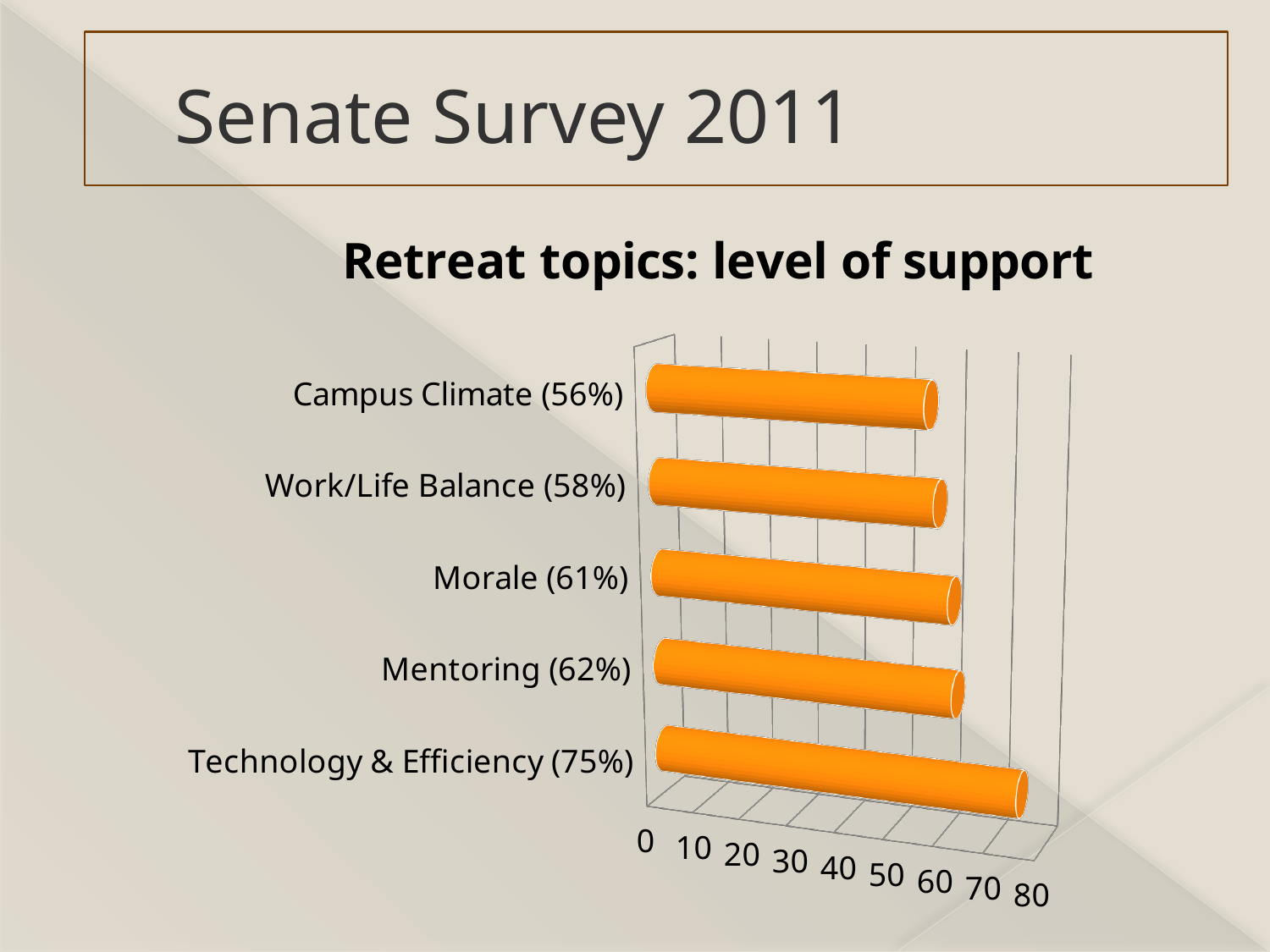
Which retreat topic has the highest level of support? Technology & Efficiency What is the chart's title? Retreat topics: level of support Which has a higher level of support, Mentoring or Work/Life Balance? Mentoring What kind of chart is shown on the slide? bar chart What level of support is shown for Technology & Efficiency? 75% Is the value for Technology & Efficiency greater or less than 70? greater What is the difference in support between Mentoring and Morale? 1% Which retreat topic has the lowest level of support? Campus Climate What is the difference in support between Technology & Efficiency and Campus Climate? 19% How many retreat topics are plotted in the chart? 5 What level of support is shown for Campus Climate? 56% What level of support is shown for Morale? 61%